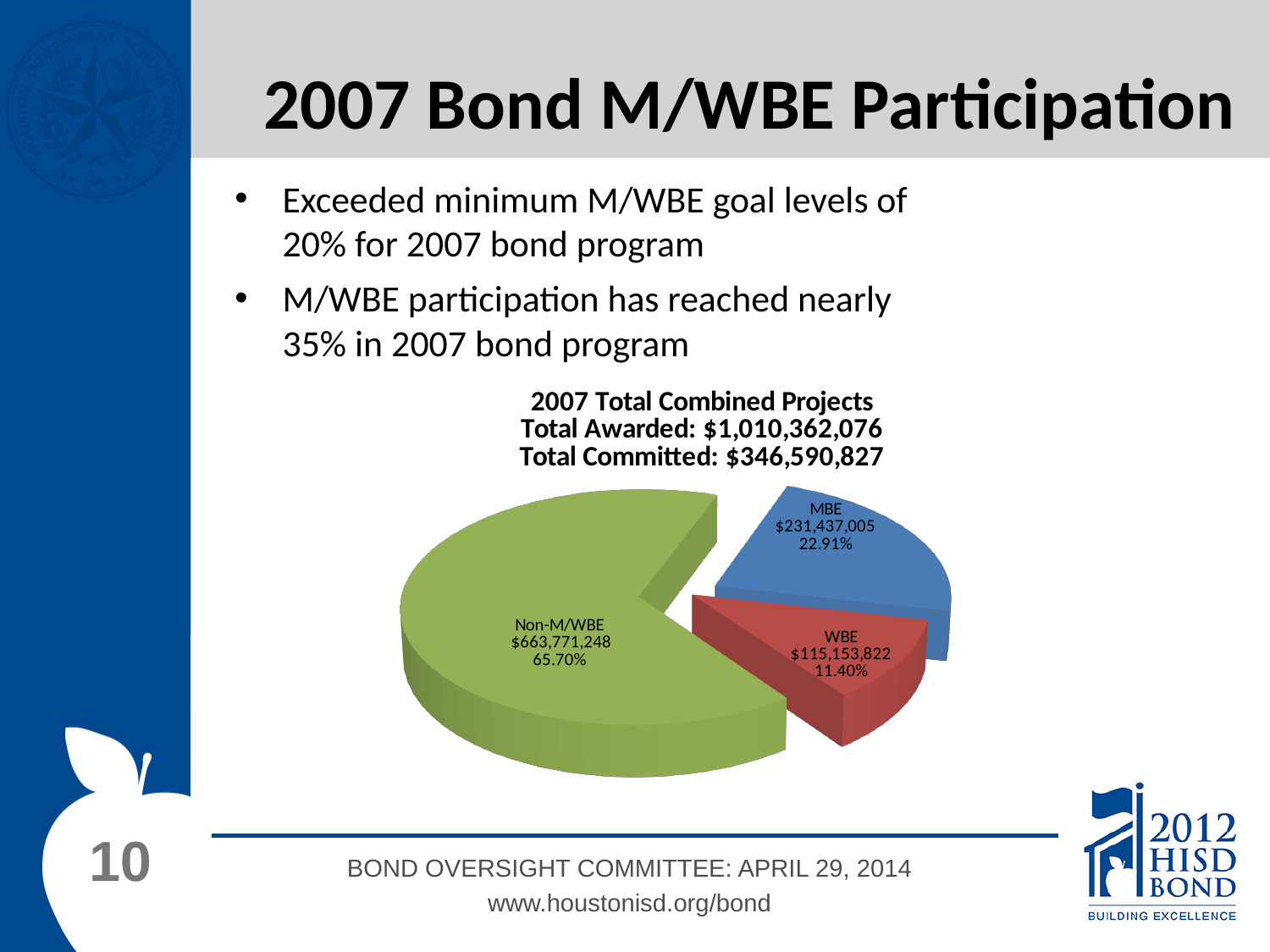
What share of the pie does the Non-M/WBE slice represent? 65.70% Which is larger, the MBE slice or the WBE slice? MBE What share of the pie does the WBE slice represent? 11.40% What is the dollar value for the WBE slice? $115,153,822 What is the dollar value for the MBE slice? $231,437,005 Which slice of the pie is the largest? Non-M/WBE Which slice of the pie is the smallest? WBE What kind of chart is shown on the slide? Pie chart What is the Total Awarded amount stated in the chart title? $1,010,362,076 What is the dollar value for the Non-M/WBE slice? $663,771,248 What share of the pie does the MBE slice represent? 22.91% How many slices does the pie chart have? 3